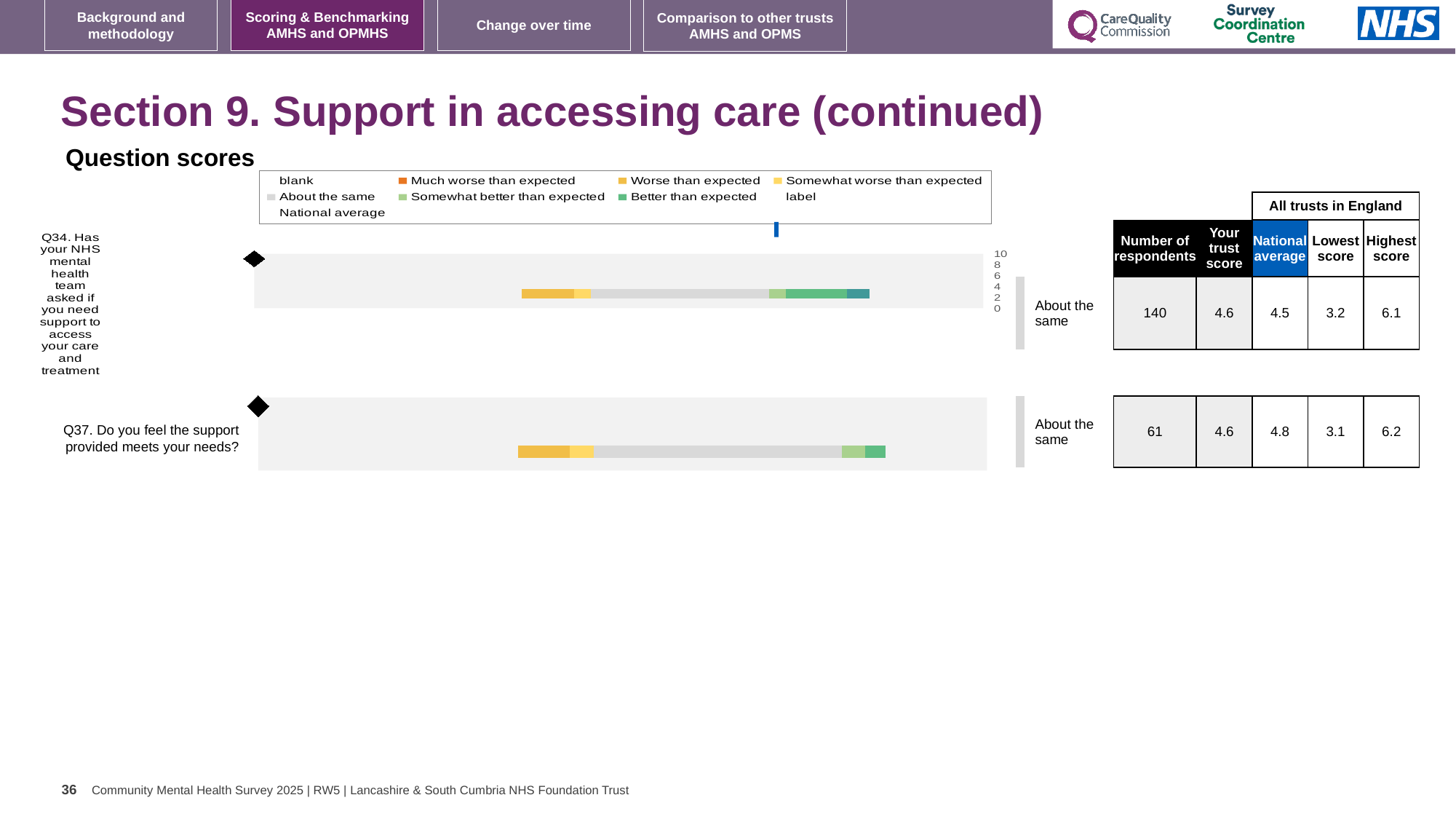
What benchmark category is shown to the right of the bar for Q34? About the same Which question has more respondents in the table beside the chart, Q34 or Q37? Q34 In the chart legend, what colour represents 'Much worse than expected'? orange What benchmark category is shown to the right of the bar for Q37 (Do you feel the support provided meets your needs?)? About the same In the table beside the chart, what is the national average for Q37? 4.8 In the table beside the chart, what is the number of respondents for Q34? 140 In the chart legend, which category is shown in grey? About the same How many survey questions are plotted as bars in the question scores chart? 2 What kind of chart is used to show the question scores on this slide? bar chart In the table beside the chart, what is 'Your trust score' for Q34? 4.6 What is the difference in the number of respondents between Q34 and Q37 in the table beside the chart? 79 In the table beside the chart, what is the number of respondents for Q37? 61